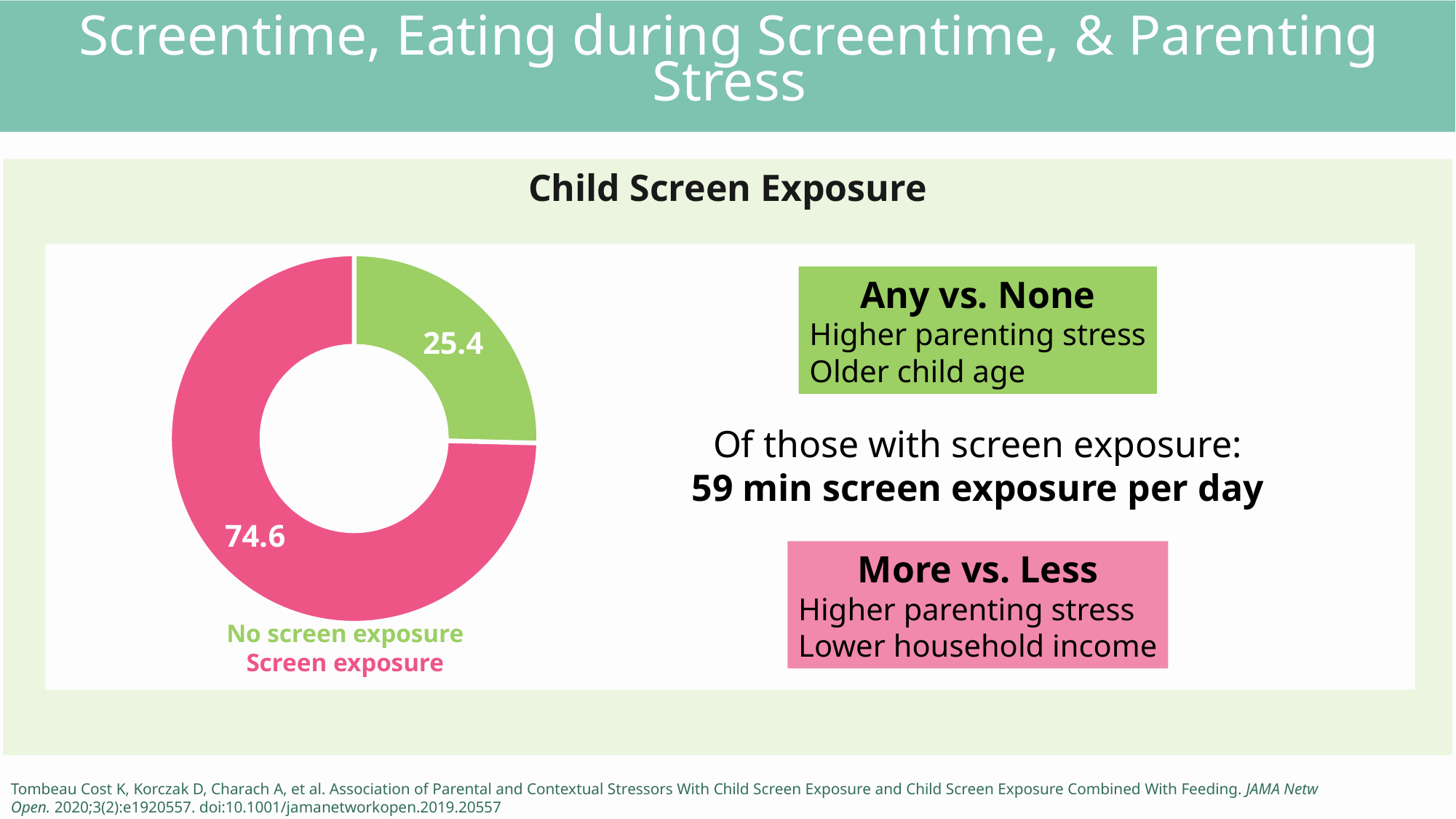
Which category has the largest slice in the Child Screen Exposure chart? Screen exposure What is the value for No screen exposure in the Child Screen Exposure chart? 25.4 Which category has the smallest slice in the Child Screen Exposure chart? No screen exposure What is the difference between the Screen exposure and No screen exposure values? 49.2 What colour represents Screen exposure in the chart? Pink Which is larger, the Screen exposure slice or the No screen exposure slice? Screen exposure What is the title of the chart on the slide? Child Screen Exposure What is the value for Screen exposure in the Child Screen Exposure chart? 74.6 What kind of chart is shown on the slide? Donut (pie) chart What is the total of the two slices in the Child Screen Exposure chart? 100 How many categories are shown in the Child Screen Exposure chart? 2